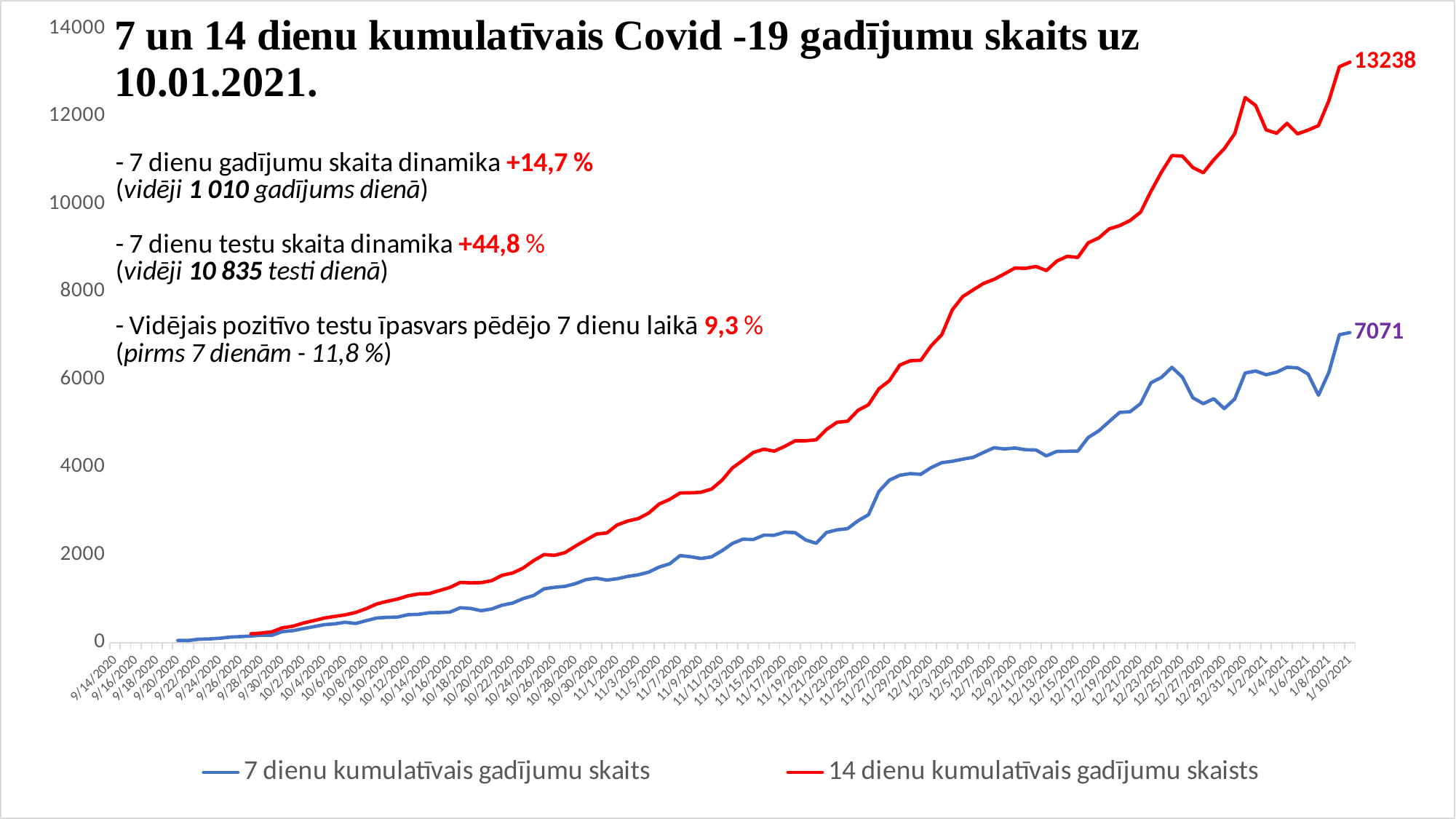
What is the final labelled value of the 7 dienu kumulatīvais gadījumu skaits series on 1/10/2021? 7071 What is the difference between the final labelled values of the 14-day series (13238) and the 7-day series (7071)? 6167 Is the value of the 14 dienu kumulatīvais gadījumu skaists series on 12/1/2020 greater or less than 6000? greater What is the title of the chart? 7 un 14 dienu kumulatīvais Covid -19 gadījumu skaits uz 10.01.2021. How many series does the legend list? 2 What colour is the line for the 14 dienu kumulatīvais gadījumu skaists series? Red Do the values of the 14 dienu kumulatīvais gadījumu skaists series generally rise or fall from 9/28/2020 to 1/10/2021? Rise Is the value of the 14 dienu kumulatīvais gadījumu skaists series on 10/20/2020 greater or less than 2000? less What kind of chart is shown on the slide? Line chart What is the final labelled value of the 14 dienu kumulatīvais gadījumu skaists series on 1/10/2021? 13238 Is the value of the 7 dienu kumulatīvais gadījumu skaits series on 11/1/2020 greater or less than 2000? less Which series has the larger value at the end of the chart, the 7 dienu or the 14 dienu series? 14 dienu kumulatīvais gadījumu skaists